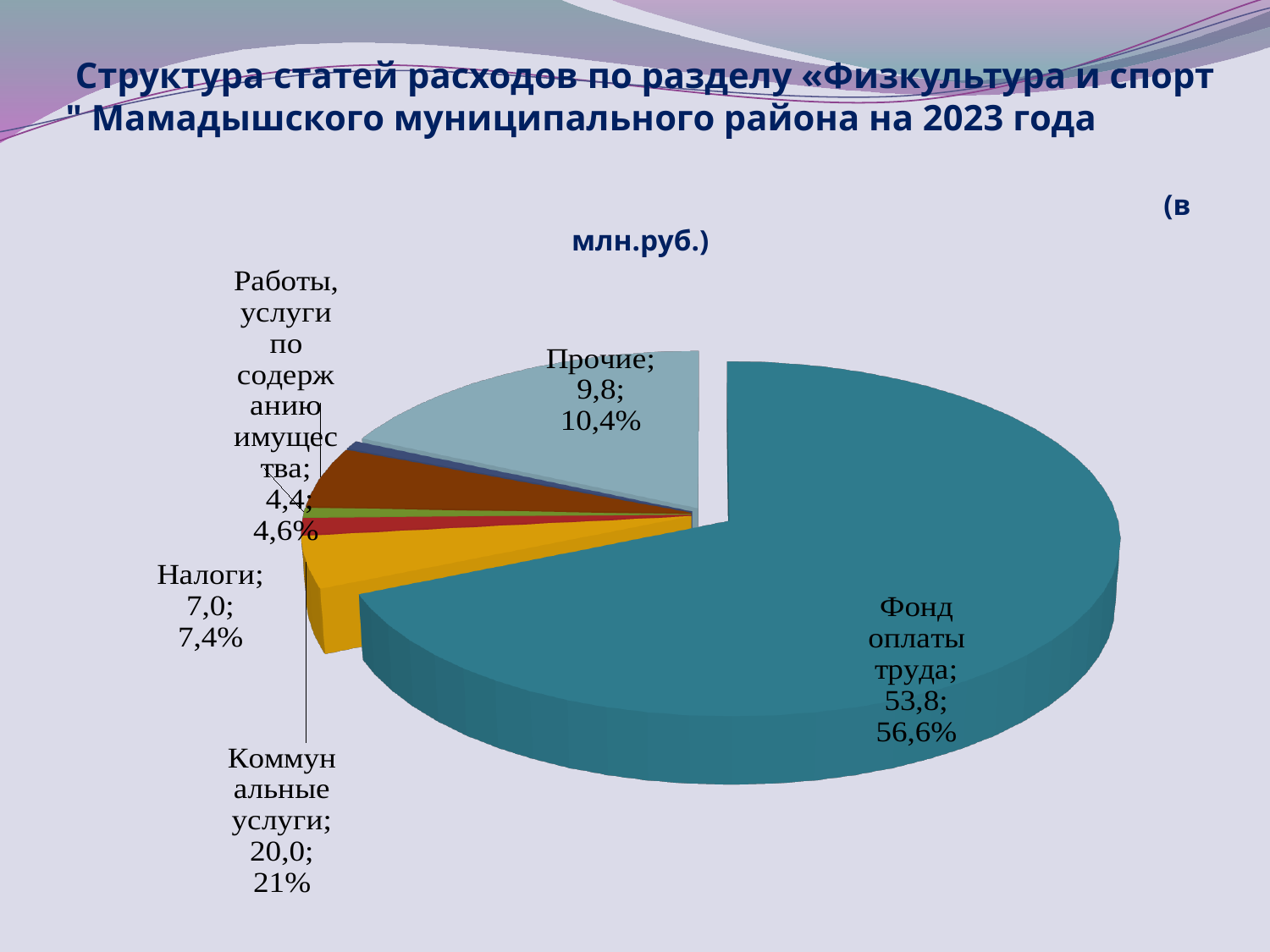
What is the value for Прочие? 9,8 What is the value for Фонд оплаты труда? 53,8 What share of the pie does Фонд оплаты труда take? 56,6% What is the value for Налоги? 7,0 What unit is given in the chart title? млн.руб. What kind of chart is shown on the slide? pie chart Which category has the largest slice of the pie? Фонд оплаты труда What is the value for Работы, услуги по содержанию имущества? 4,4 What is the value for Коммунальные услуги? 20,0 What share of the pie does Коммунальные услуги take? 21% What is the difference between the values for Фонд оплаты труда and Коммунальные услуги? 33,8 Which is larger, the value for Прочие or the value for Налоги? Прочие